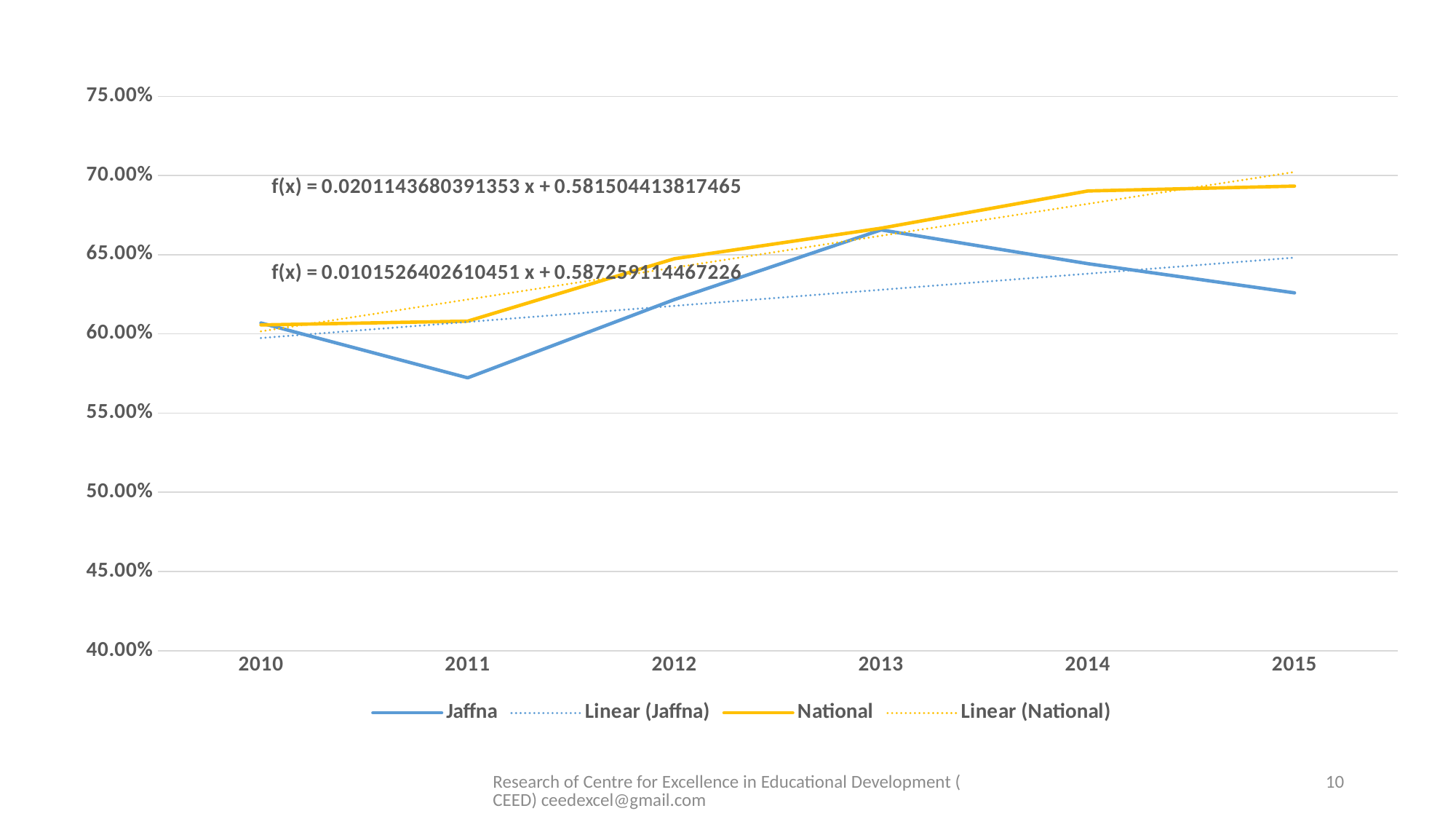
Does the National series rise or fall from 2010 to 2015? rises What kind of chart is shown on the slide? line chart In 2015, which series has the larger value, Jaffna or National? National In which year is the Jaffna value highest? 2013 How many entries does the legend list? 4 In which year is the Jaffna value lowest? 2011 In 2011, which series has the larger value, Jaffna or National? National Is the Jaffna value for 2011 greater or less than 60.00%? less How many years are plotted along the x axis? 6 Which legend entry corresponds to the dotted blue line? Linear (Jaffna) Is the National value for 2014 greater or less than 65.00%? greater Is the Jaffna value for 2015 greater or less than 65.00%? less